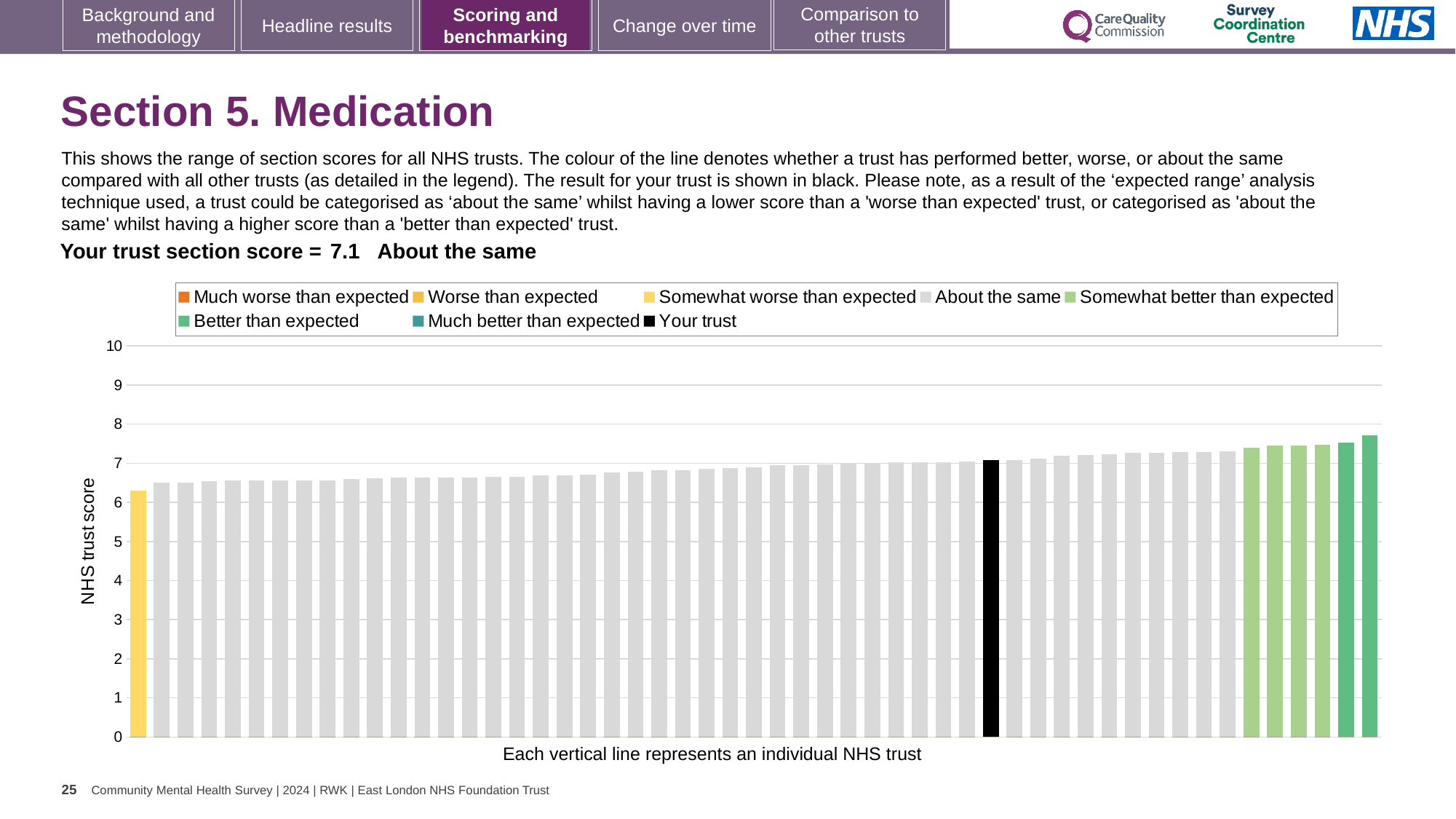
Which performance category is your trust placed in for Section 5. Medication? About the same What colour is the bar representing your trust? black What is the label on the vertical axis of the chart? NHS trust score Is the value of the lowest bar (the leftmost, yellow bar) greater or less than 7? less What kind of chart is shown on the slide? bar chart What is the section score for your trust shown on the slide? 7.1 Is your trust's section score greater or less than 7? greater Which legend category does the tallest bar belong to? Better than expected How many entries does the chart legend list? 8 Do the bar values rise or fall from left to right along the x axis? rise Which legend category does the lowest bar belong to? Somewhat worse than expected Is the value of the tallest bar (the rightmost bar) greater or less than 8? less